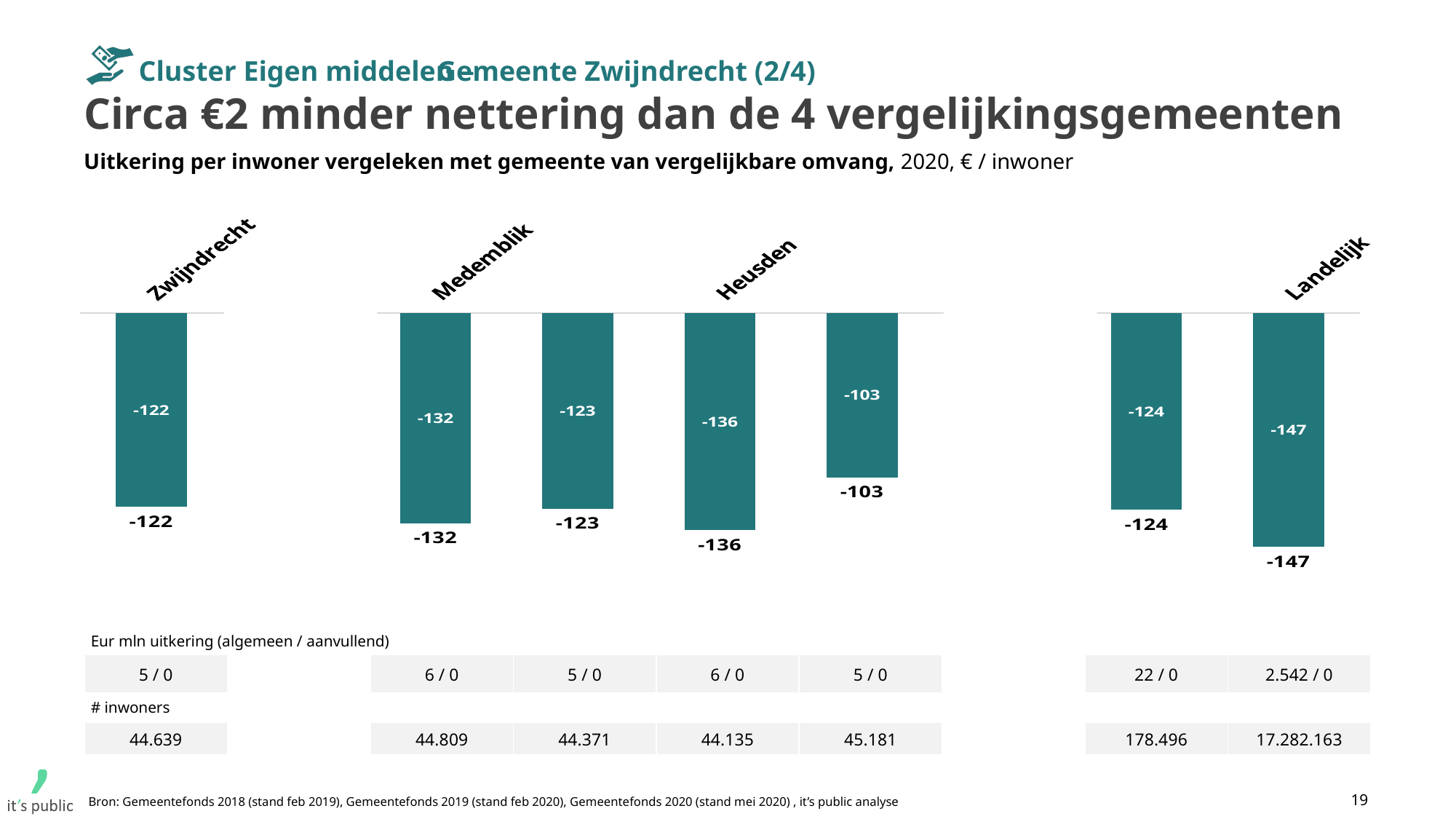
What kind of chart is shown on the slide? Bar chart Which has the more negative value, Zwijndrecht or Medemblik? Medemblik What is the difference between the values for Medemblik (-132) and Heusden (-136)? 4 What colour are the bars in the chart? Teal What is the difference between the values for Zwijndrecht (-122) and Landelijk (-147)? 25 Which bar on the chart has the most negative value? Landelijk What is the value shown for Zwijndrecht? -122 Which has the more negative value, Medemblik or Heusden? Heusden What is the value shown for Medemblik? -132 How many bars are plotted on the chart? 7 What is the value shown for Heusden? -136 What is the value shown for Landelijk? -147